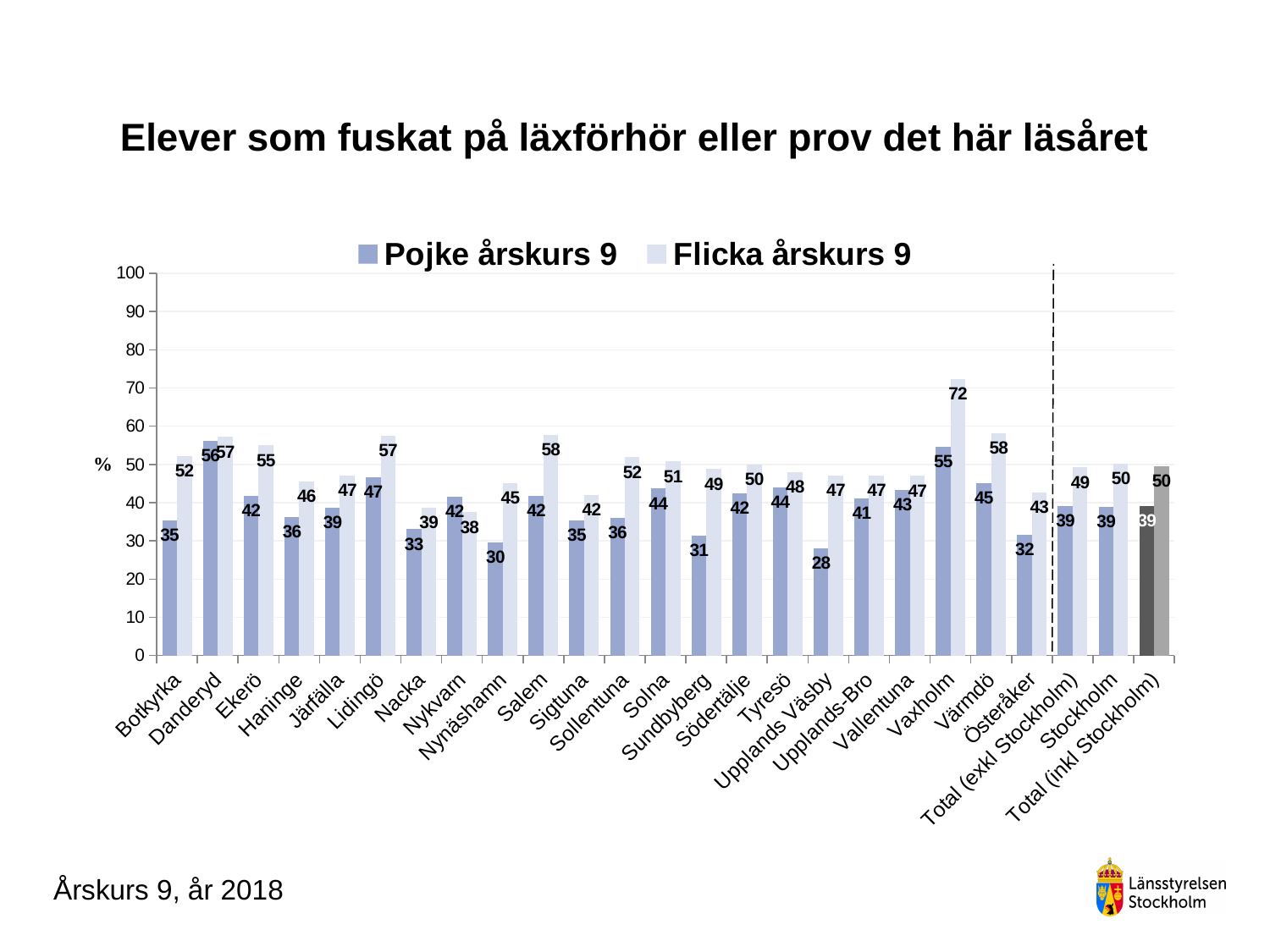
What is the value for Pojke årskurs 9 in Vaxholm? 55 What is the value for Flicka årskurs 9 in Salem? 58 What is the value for Pojke årskurs 9 in Upplands Väsby? 28 What is the title of the chart? Elever som fuskat på läxförhör eller prov det här läsåret How many series does the legend list? 2 Which municipality has the highest value for Flicka årskurs 9? Vaxholm Which category has the lowest value for Pojke årskurs 9? Upplands Väsby What is the difference between Flicka årskurs 9 and Pojke årskurs 9 in Vaxholm? 17 What kind of chart is shown on the slide? Bar chart Which is larger in Nykvarn: Pojke årskurs 9 or Flicka årskurs 9? Pojke årskurs 9 How many categories are shown on the x axis? 25 Is the value for Flicka årskurs 9 in Vaxholm greater or less than 70? greater